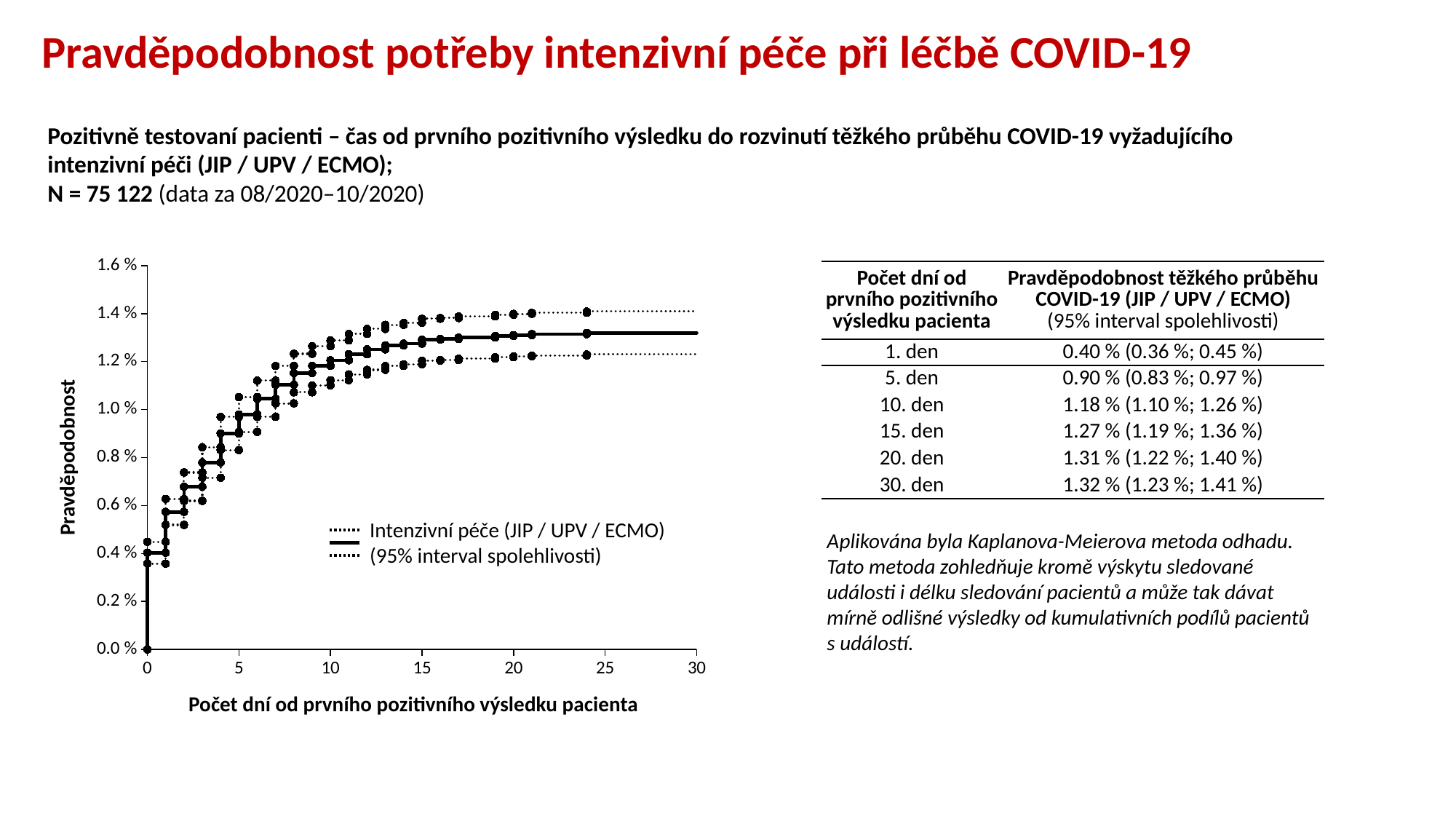
Using the table values, what is the difference in probability between day 30 (1.32 %) and day 1 (0.40 %)? 0.92 % What is the highest value shown on the y axis of the chart? 1.6 % Is the probability value at day 5 greater or less than 1.0 %? less How many entries does the chart legend list? 2 According to the table, what is the probability of severe COVID-19 course on day 1 (1. den)? 0.40 % Does the probability curve rise or fall as the number of days since the first positive result increases? rises What kind of chart is shown on the slide? line chart According to the table, what is the probability of severe COVID-19 course on day 10 (10. den)? 1.18 % What is the 95% confidence interval listed for day 15 (15. den) in the table? (1.19 %; 1.36 %) Is the probability value at day 1 greater or less than 0.6 %? less Is the probability value at day 20 greater or less than 1.2 %? greater According to the table, what is the probability of severe COVID-19 course on day 30 (30. den)? 1.32 %